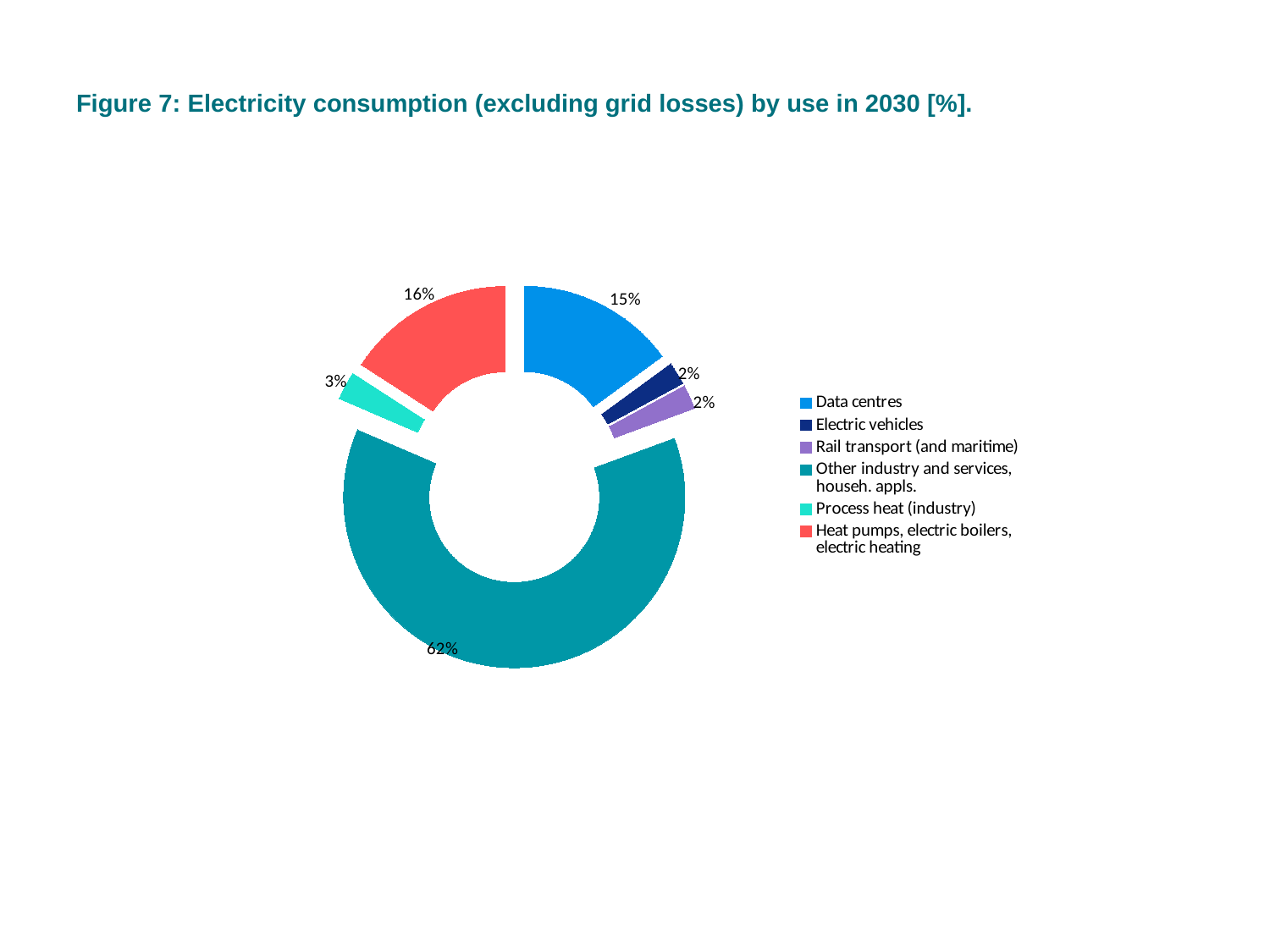
What share of electricity consumption in 2030 is attributed to Other industry and services, househ. appls.? 62% What share of electricity consumption in 2030 is attributed to Heat pumps, electric boilers, electric heating? 16% What is the title of the chart? Figure 7: Electricity consumption (excluding grid losses) by use in 2030 [%]. Which use accounts for the largest share of electricity consumption in 2030? Other industry and services, househ. appls. How many categories does the chart show? 6 What share of electricity consumption in 2030 is attributed to Process heat (industry)? 3% What share of electricity consumption in 2030 is attributed to Data centres? 15% Which has a larger share: Data centres or Process heat (industry)? Data centres What kind of chart is shown on the slide? Pie chart (doughnut) What is the difference in share between Heat pumps, electric boilers, electric heating and Data centres? 1% What is the difference in share between Other industry and services, househ. appls. and Data centres? 47% What share of electricity consumption in 2030 is attributed to Electric vehicles? 2%